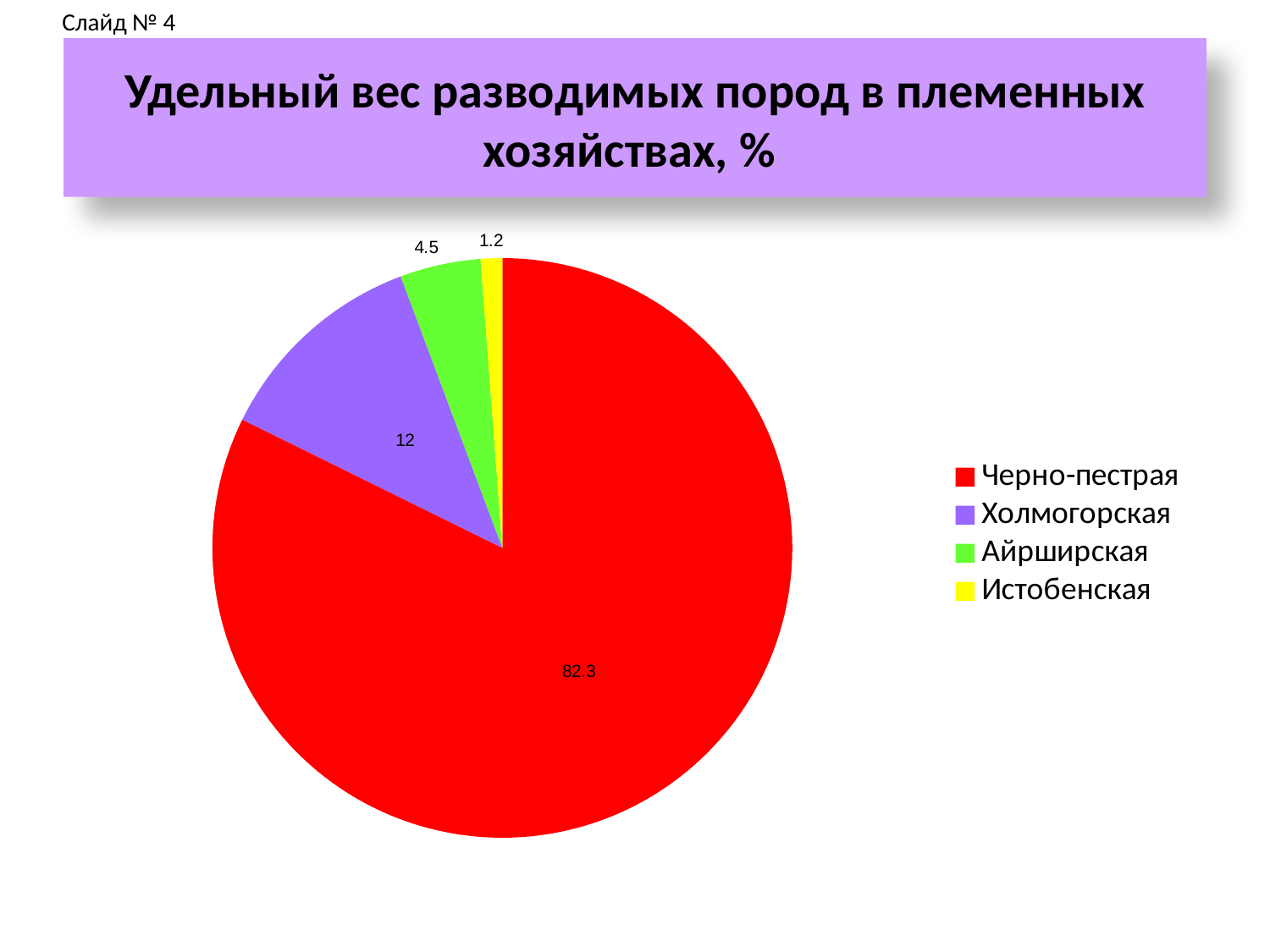
What is the value for Холмогорская? 12 What is the difference between the values for Черно-пестрая and Холмогорская? 70.3 How many slices does the pie chart have? 4 What is the value for Истобенская? 1.2 Which is larger, the value for Айрширская or the value for Истобенская? Айрширская Which breed has the smallest share of the pie? Истобенская What is the value for Черно-пестрая? 82.3 Which breed has the largest share of the pie? Черно-пестрая How many entries does the legend list? 4 What kind of chart is shown on the slide? pie chart What is the value for Айрширская? 4.5 Which colour represents Холмогорская in the pie chart? purple